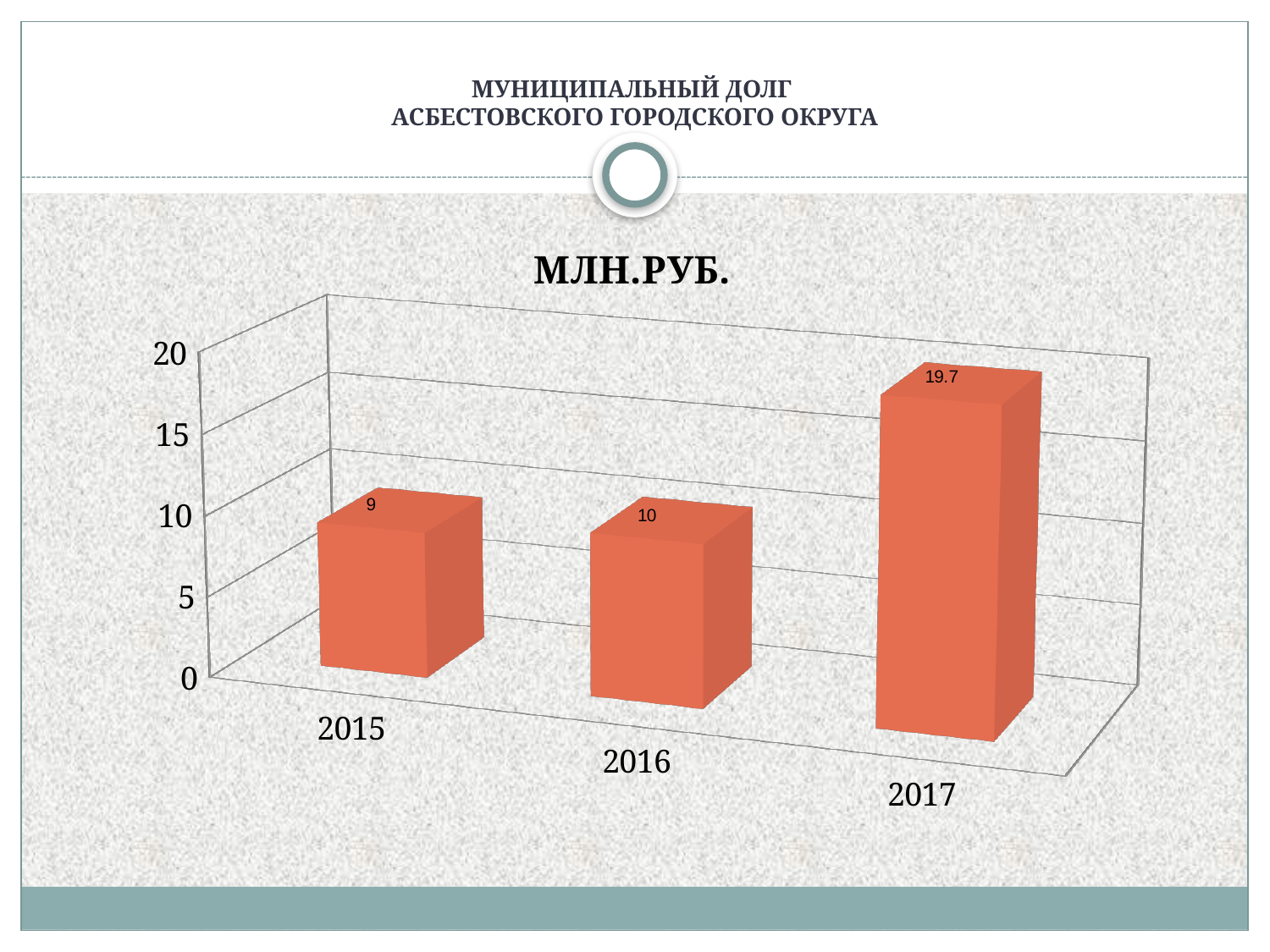
Which year has the lowest value? 2015 What is the value for 2017? 19.7 What is the value for 2016? 10 What is the difference between the values for 2017 and 2016? 9.7 What is the difference between the values for 2016 and 2015? 1 Which is larger, the value for 2017 or the value for 2015? 2017 Which year has the highest value? 2017 What is the value for 2015? 9 How many years are shown on the chart? 3 Is the value for 2017 greater or less than 15? greater Do the values rise or fall from 2015 to 2017? rise What kind of chart is shown on the slide? bar chart